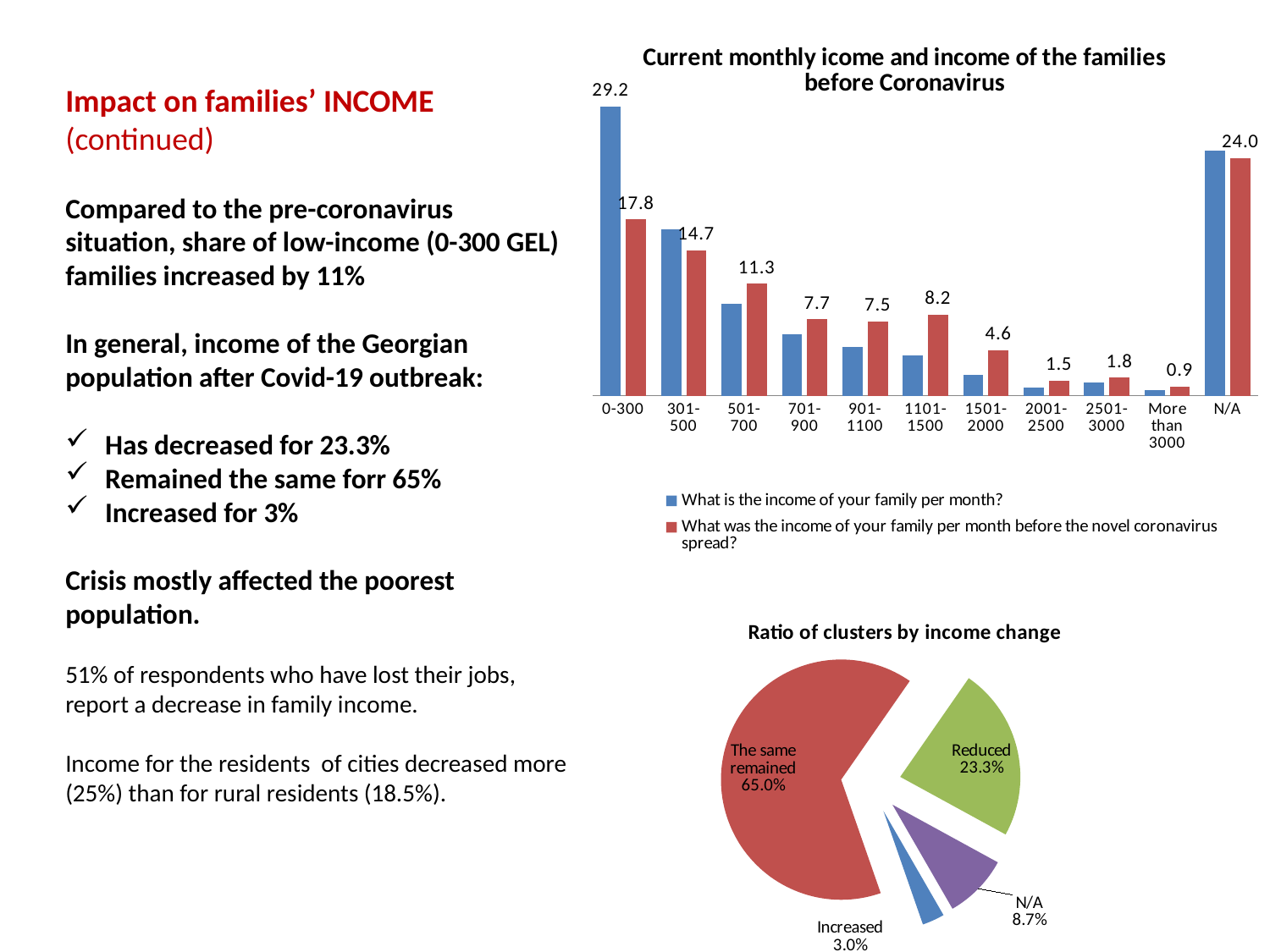
How many series does the legend of the bar chart 'Current monthly icome and income of the families before Coronavirus' list? 2 In the pie chart 'Ratio of clusters by income change', what share does the 'Reduced' slice have? 23.3% How many income categories are shown on the x axis of the bar chart 'Current monthly icome and income of the families before Coronavirus'? 11 In the bar chart 'Current monthly icome and income of the families before Coronavirus', which category has the lowest value in the series 'What was the income of your family per month before the novel coronavirus spread?'? More than 3000 In the pie chart 'Ratio of clusters by income change', which slice is the largest? The same remained In the bar chart 'Current monthly icome and income of the families before Coronavirus', what is the difference between the current income value and the pre-coronavirus value for the 0-300 category? 11.4 What kind of chart is the chart titled 'Current monthly icome and income of the families before Coronavirus'? bar chart In the pie chart 'Ratio of clusters by income change', which slice is the smallest? Increased In the bar chart 'Current monthly icome and income of the families before Coronavirus', what is the value for the 0-300 category in the series 'What was the income of your family per month before the novel coronavirus spread?'? 17.8 In the bar chart 'Current monthly icome and income of the families before Coronavirus', what is the value for the 0-300 category in the series 'What is the income of your family per month?'? 29.2 In the bar chart 'Current monthly icome and income of the families before Coronavirus', for the 0-300 category, which is larger: the current income value or the pre-coronavirus value? the current income value In the bar chart 'Current monthly icome and income of the families before Coronavirus', what is the value for the N/A category in the series 'What was the income of your family per month before the novel coronavirus spread?'? 24.0